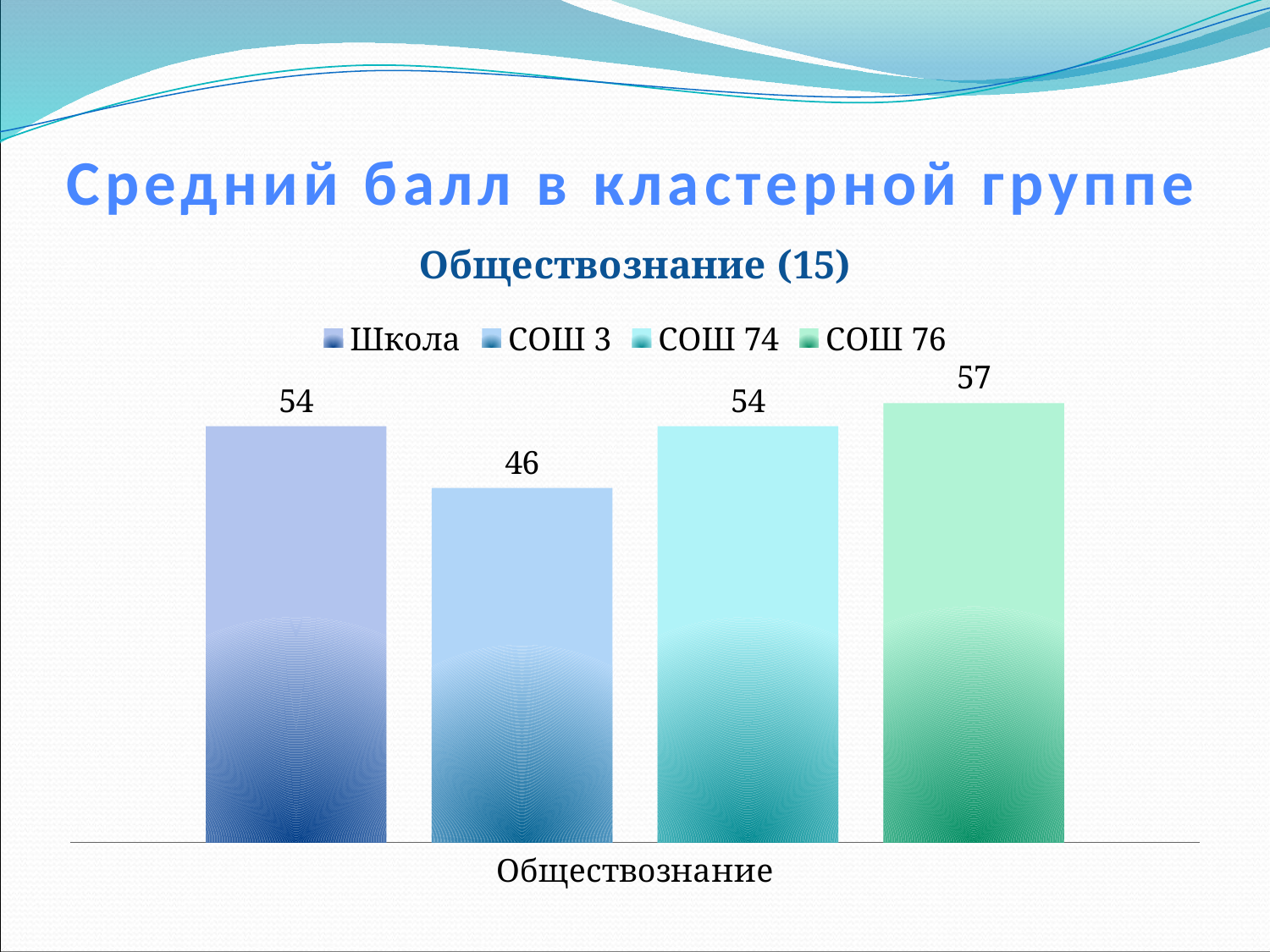
Which series has the highest value? СОШ 76 What is the value for СОШ 3? 46 How many series does the legend list? 4 What is the value for СОШ 74? 54 What is the difference between the values for СОШ 76 and СОШ 3? 11 What is the value for Школа? 54 Which is larger, the value for СОШ 76 or the value for СОШ 74? СОШ 76 What is the difference between the values for Школа and СОШ 3? 8 What is the title of the chart? Обществознание (15) What is the value for СОШ 76? 57 What kind of chart is shown on the slide? Bar chart Which series has the lowest value? СОШ 3